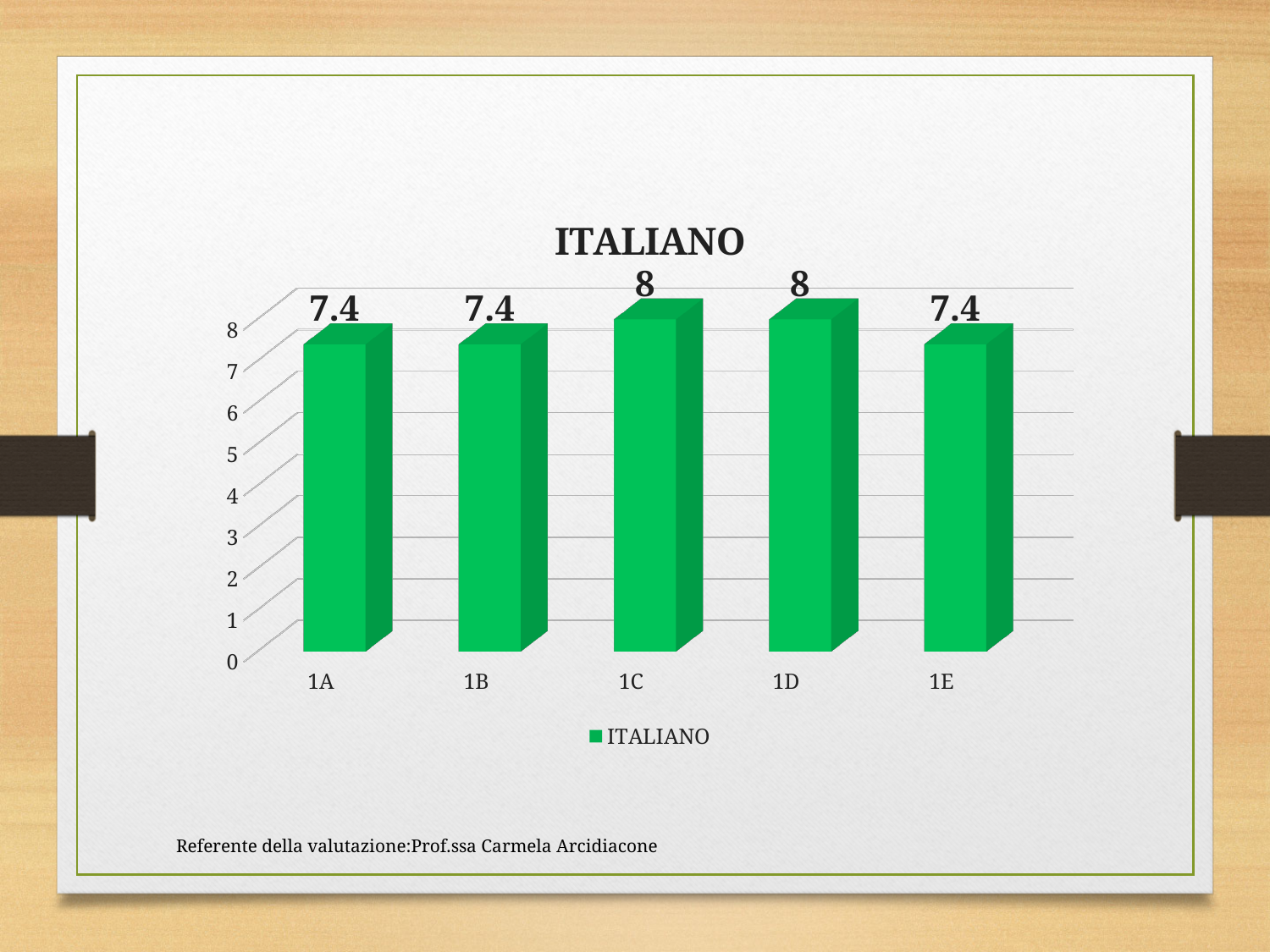
What is the difference between the values for 1C and 1B? 0.6 Is the value for 1B greater or less than 5? greater What is the value for 1A? 7.4 How many series does the legend list? 1 What is the value for 1E? 7.4 How many categories are shown on the x axis? 5 What is the value for 1C? 8 What kind of chart is shown? bar chart What colour are the bars? green What is the value for 1D? 8 What is the title of the chart? ITALIANO Which is larger, the value for 1D or the value for 1E? 1D